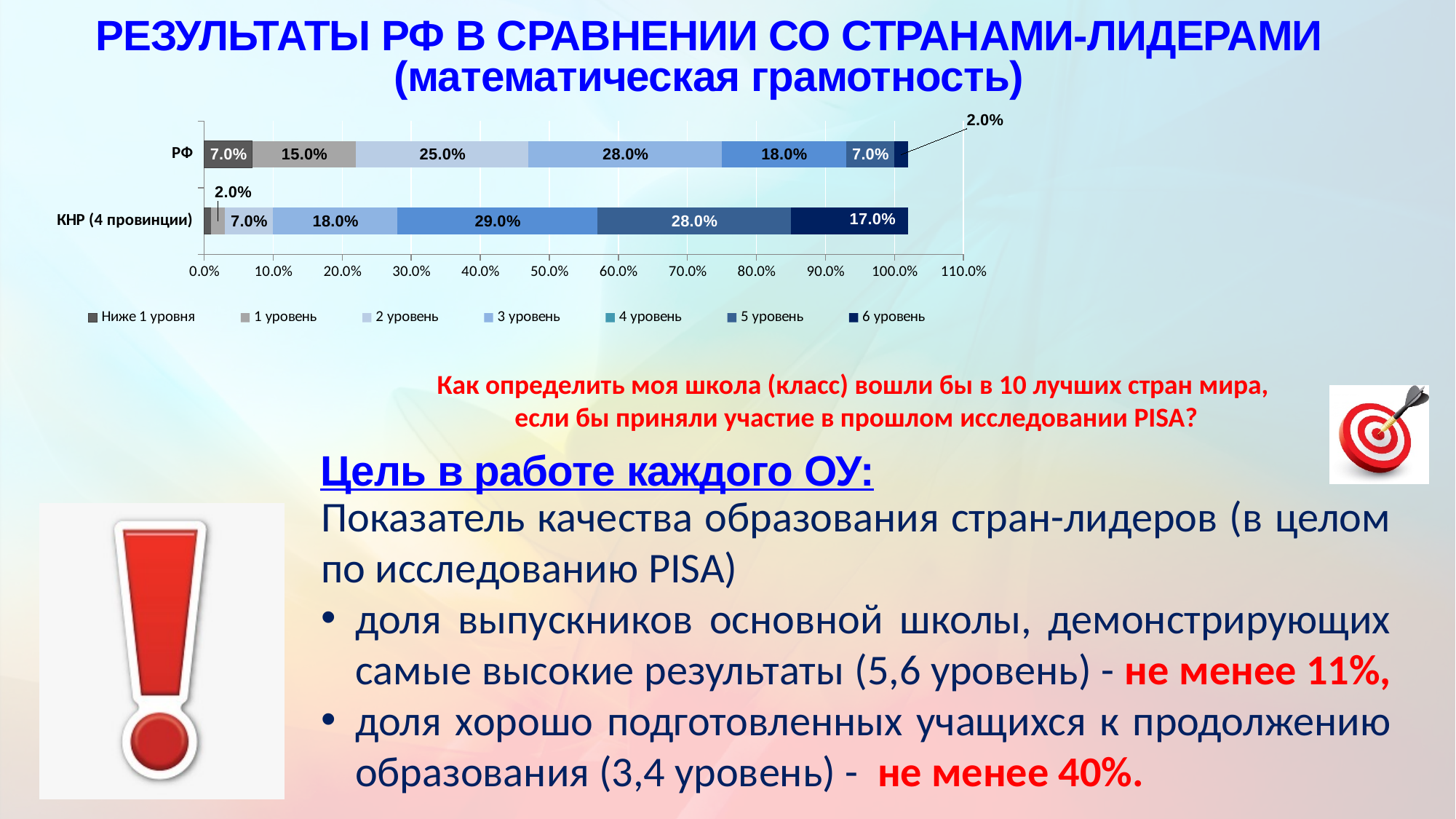
How many series does the chart legend list? 7 What is the title of the slide containing the chart? РЕЗУЛЬТАТЫ РФ В СРАВНЕНИИ СО СТРАНАМИ-ЛИДЕРАМИ (математическая грамотность) What is the value of the 'Ниже 1 уровня' segment for РФ? 7.0% What is the value of the '3 уровень' segment for РФ? 28.0% What kind of chart is shown on the slide? Stacked bar chart How many categories (countries) are plotted in the chart? 2 What is the value of the '2 уровень' segment for КНР (4 провинции)? 7.0% What is the value of the '6 уровень' segment for РФ? 2.0% What is the largest segment value in the КНР (4 провинции) bar? 29.0% What is the difference between the '2 уровень' values for РФ and КНР (4 провинции)? 18.0% Which category has the larger '1 уровень' value, РФ or КНР (4 провинции)? РФ